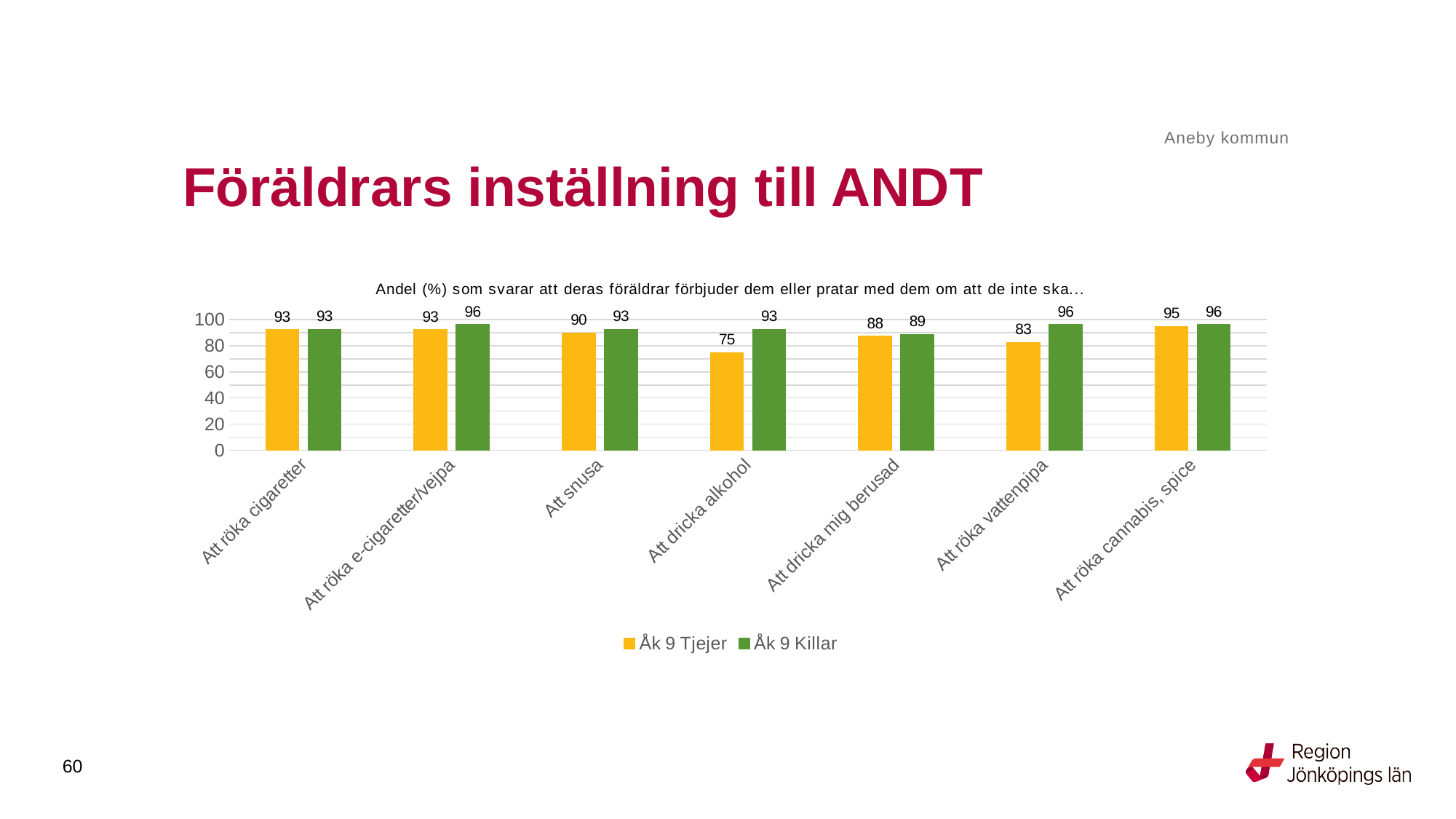
What is the difference between Åk 9 Killar and Åk 9 Tjejer for "Att röka vattenpipa"? 13 Which category has the lowest value for Åk 9 Tjejer? Att dricka alkohol Which category has the highest value for Åk 9 Tjejer? Att röka cannabis, spice What kind of chart is shown on the slide? Bar chart What is the value for Åk 9 Killar for "Att röka vattenpipa"? 96 Which category has the lowest value for Åk 9 Killar? Att dricka mig berusad How many series does the legend list? 2 How many categories are shown on the x axis? 7 Which is larger for "Att röka e-cigaretter/vejpa": Åk 9 Tjejer or Åk 9 Killar? Åk 9 Killar What is the value for Åk 9 Tjejer for "Att snusa"? 90 What is the difference between Åk 9 Killar and Åk 9 Tjejer for "Att dricka alkohol"? 18 What is the value for Åk 9 Tjejer for "Att dricka alkohol"? 75